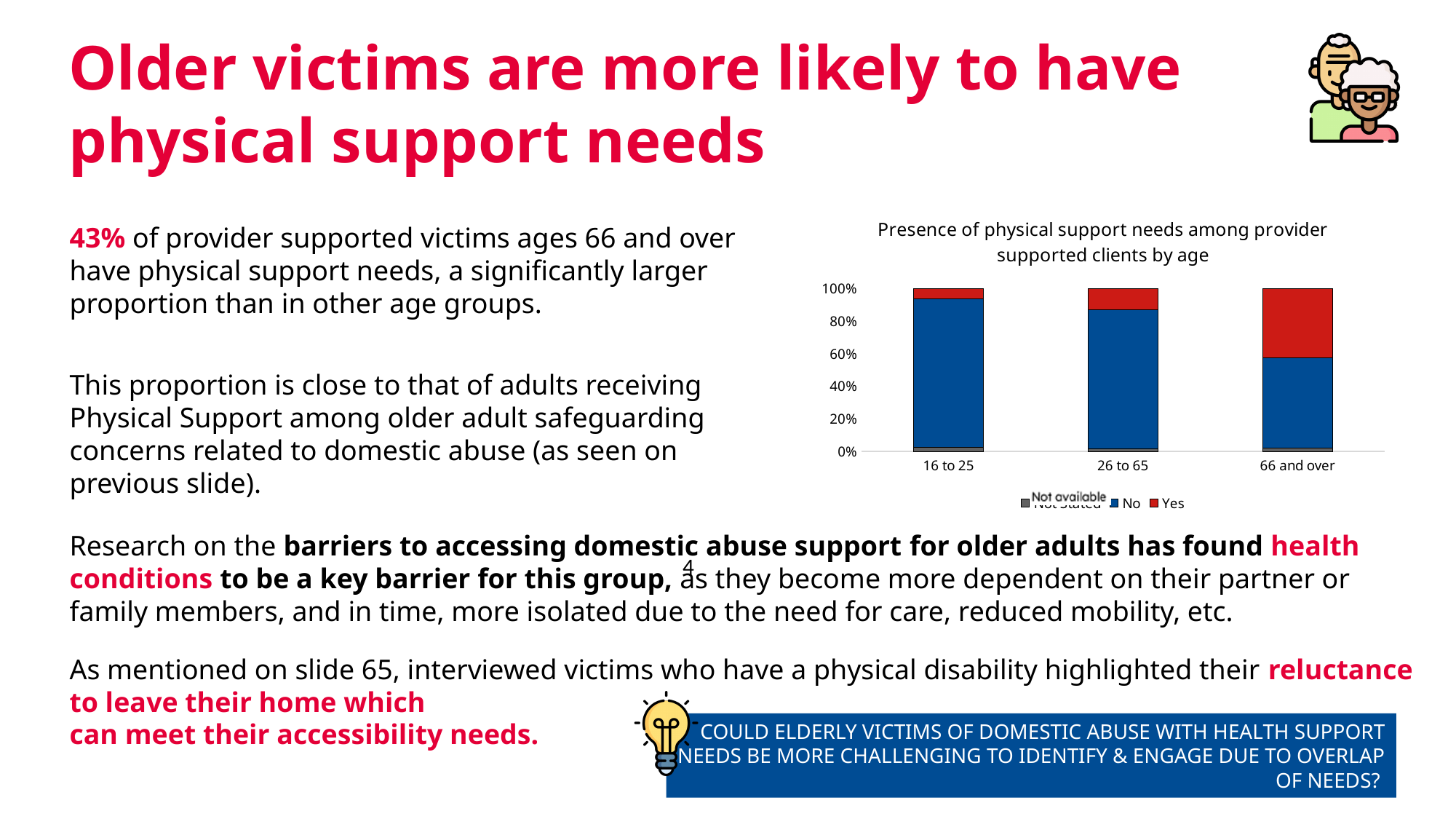
What is the title of the chart? Presence of physical support needs among provider supported clients by age Is the 'No' share for 26 to 65 greater or less than 60%? greater Is the 'Yes' share for 16 to 25 greater or less than 20%? less What kind of chart is shown on the slide? Stacked bar chart Does the 'Yes' share rise or fall as age group increases along the x axis? rise Which age group has the largest 'Yes' share in the chart? 66 and over Which is larger: the 'Yes' share for 26 to 65 or for 66 and over? 66 and over Is the 'Yes' share for 66 and over greater or less than 20%? greater How many series does the chart legend list? 3 How many age groups are shown on the x axis of the chart? 3 Which age group has the largest 'No' share in the chart? 16 to 25